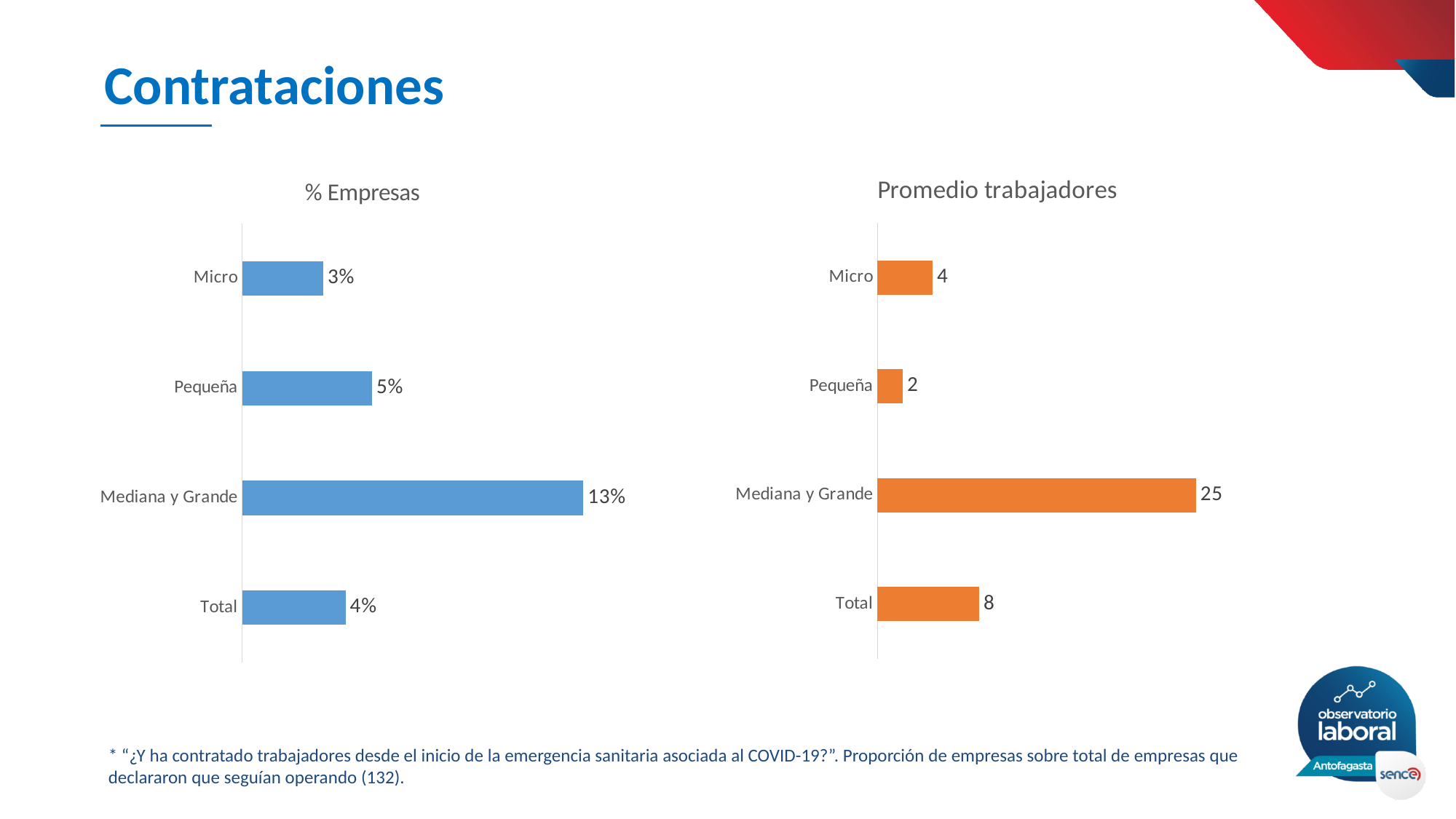
What kind of chart is the 'Promedio trabajadores' chart? Bar chart What is the title of the chart on the left of the slide? % Empresas In the 'Promedio trabajadores' chart, what is the value for Total? 8 In the '% Empresas' chart, what is the difference between Mediana y Grande and Pequeña? 8% In the '% Empresas' chart, what is the value for Mediana y Grande? 13% In the 'Promedio trabajadores' chart, which category has the lowest value? Pequeña In the 'Promedio trabajadores' chart, what is the value for Pequeña? 2 In the 'Promedio trabajadores' chart, which is larger, Micro or Pequeña? Micro How many categories does the '% Empresas' chart show? 4 In the '% Empresas' chart, what is the value for Micro? 3% In the 'Promedio trabajadores' chart, what is the difference between Mediana y Grande and Total? 17 In the '% Empresas' chart, which category has the highest value? Mediana y Grande